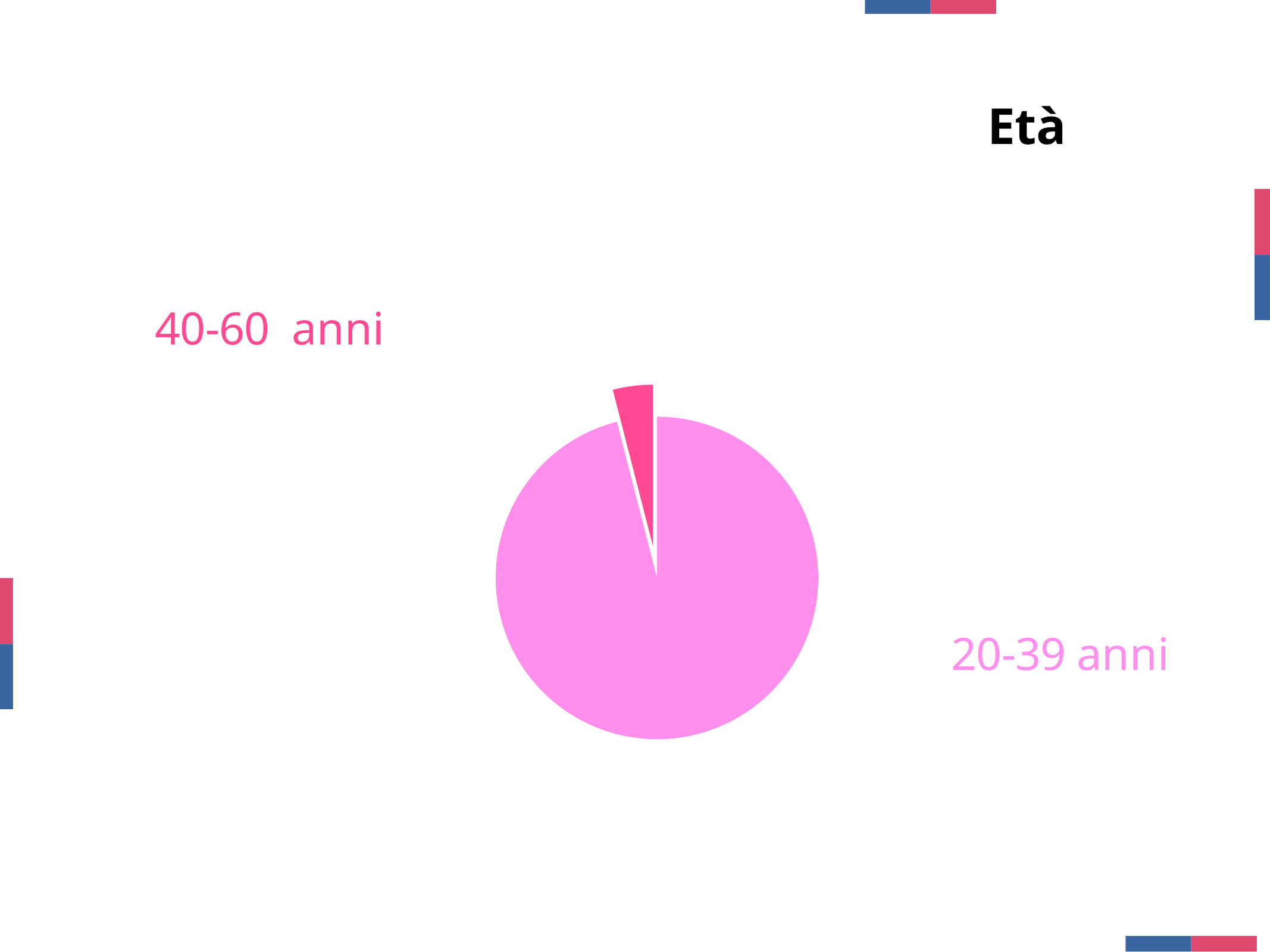
Which is larger in the pie chart: the 20-39 anni slice or the 40-60 anni slice? 20-39 anni How many slices does the pie chart have? 2 Which age group has the largest share of the pie chart? 20-39 anni What kind of chart is shown on the slide? pie chart Which age group is shown in the light pink colour? 20-39 anni Which age group has the smallest share of the pie chart? 40-60 anni What is the title of the chart? Età